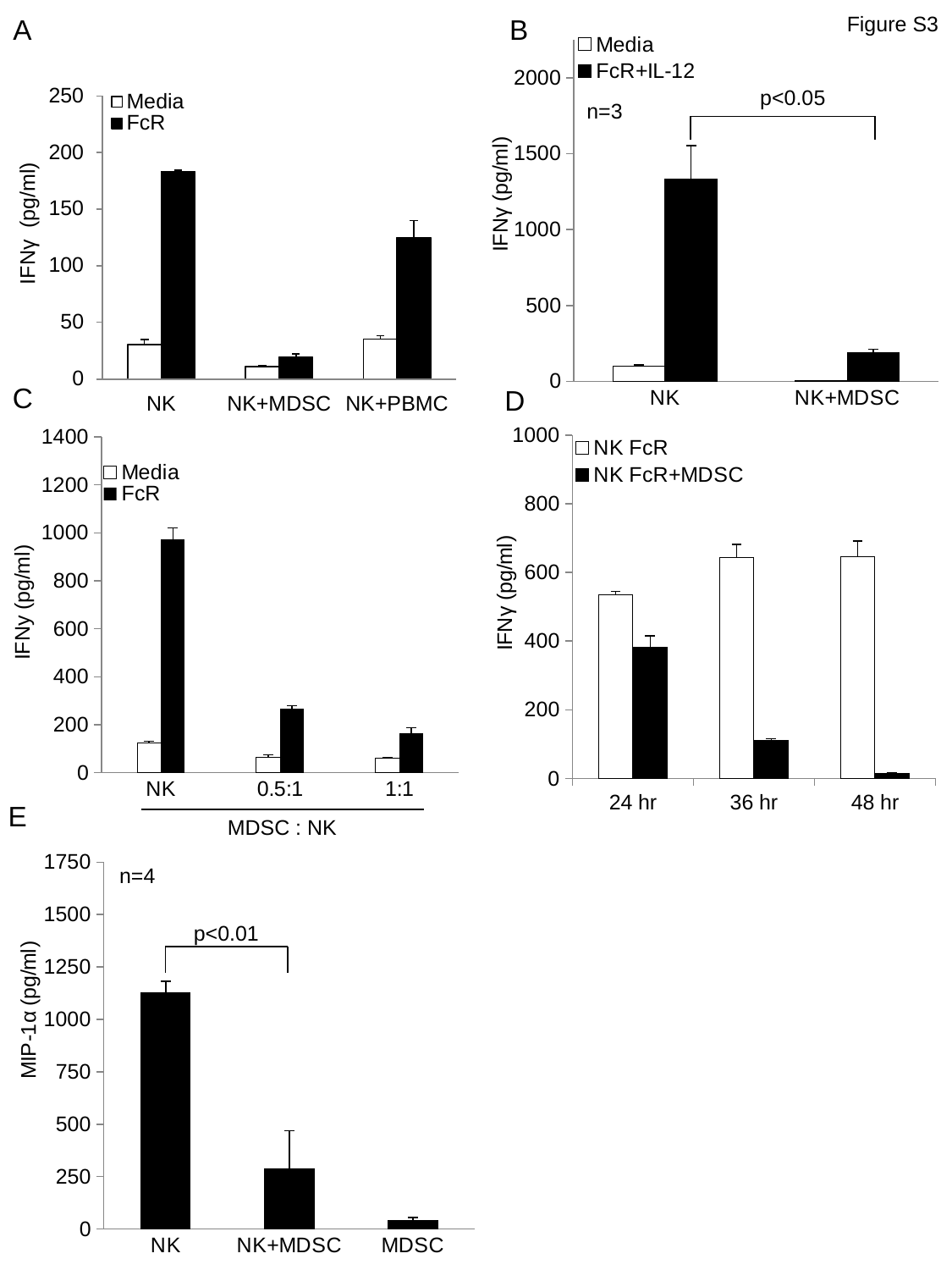
In chart D, is the NK FcR+MDSC value at 48 hr greater or less than 100? less In chart A, is the FcR value for NK+MDSC greater or less than 50? less In chart A, which category has the highest FcR bar? NK In chart B, which series does the legend list besides Media? FcR+IL-12 In chart B, is the FcR+IL-12 value for NK greater or less than 1000? greater In chart E, which category has the lowest MIP-1α value? MDSC In chart E, how many categories are shown on the x axis? 3 What kind of chart is chart E? bar chart In chart D, do the NK FcR+MDSC values rise or fall from 24 hr to 48 hr? fall In chart C, do the FcR values rise or fall from NK to 1:1 along the x axis? fall